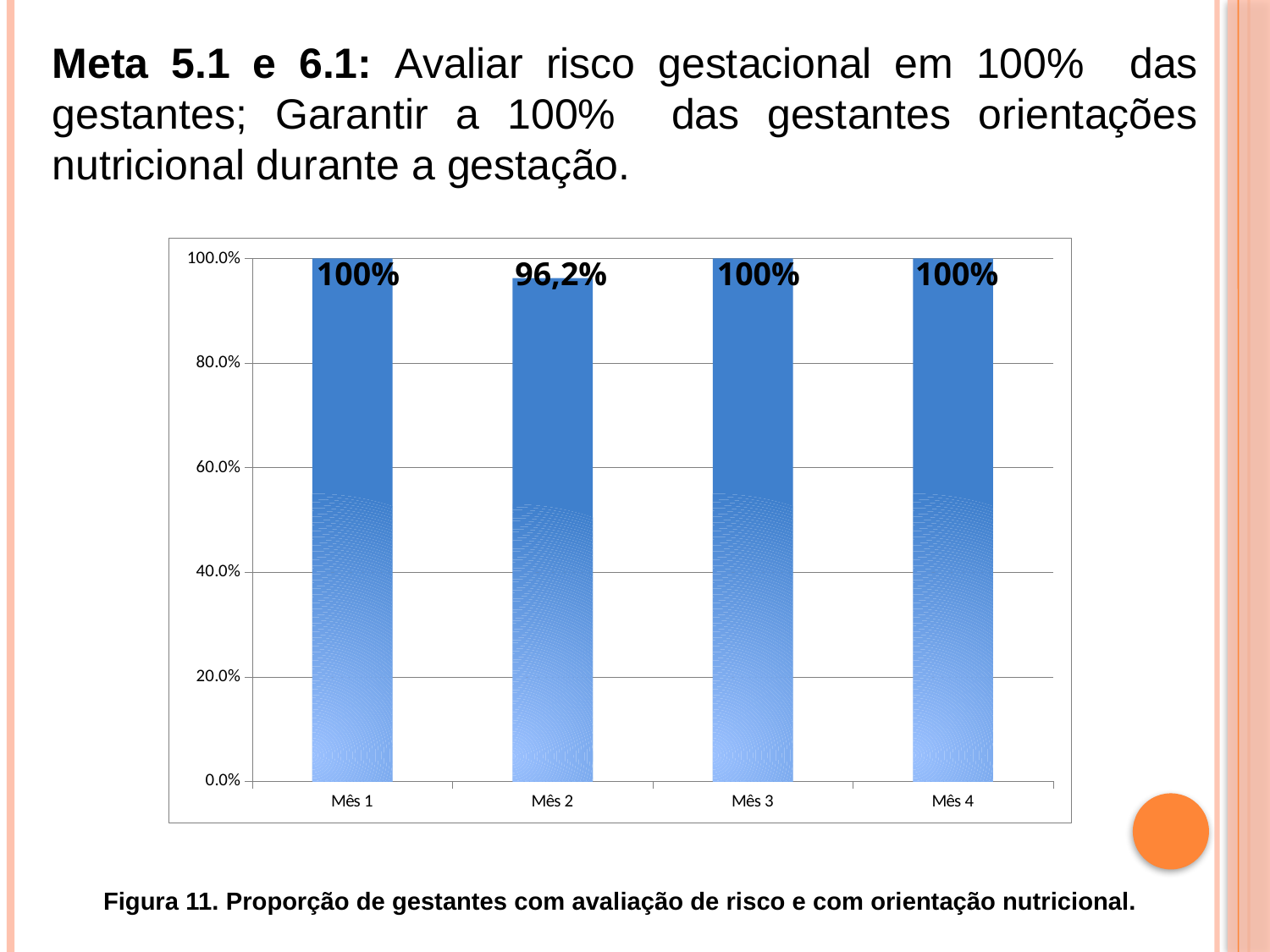
What is the value for Mês 4? 100% What is the value for Mês 2? 96,2% What is the value for Mês 1? 100% Which is larger, the value for Mês 2 or the value for Mês 3? Mês 3 What is the difference between the values for Mês 1 and Mês 2? 3,8% How many bars reach 100%? 3 What is the figure number given in the caption below the chart? Figura 11 What is the highest value shown on the y axis? 100.0% Is the value for Mês 2 greater or less than 80.0%? greater What kind of chart is shown on the slide? bar chart How many months are shown on the x axis? 4 Which month has the lowest value? Mês 2